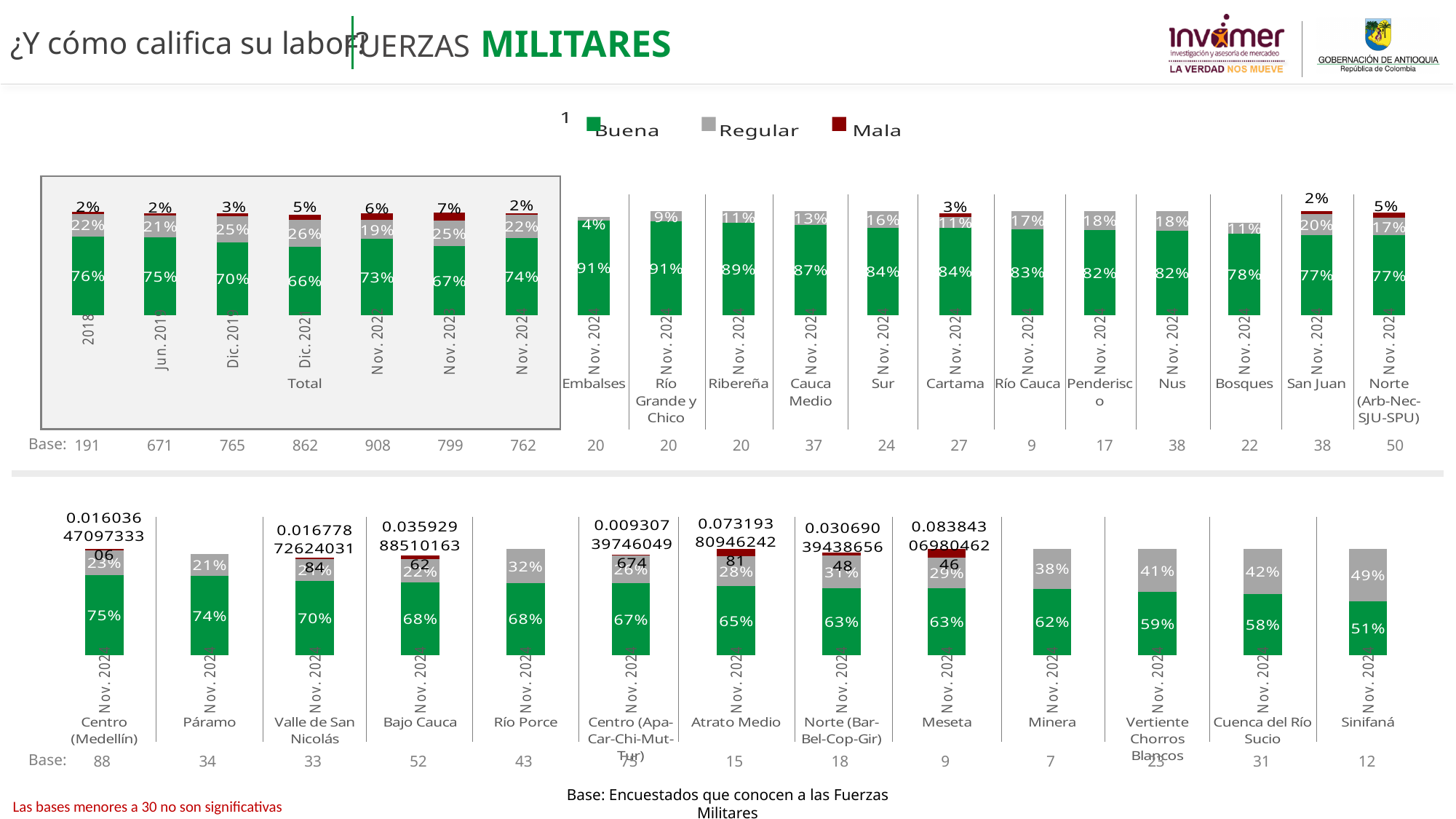
Which has a higher "Buena" percentage, Cauca Medio or Sur? Cauca Medio What is the "Buena" percentage for Sinifaná? 51% In the Total series, what is the difference in percentage points between the "Buena" value for 2018 and for Nov. 2024? 2 What percentage of respondents rated the Fuerzas Militares as "Buena" in the Embalses subregion? 91% Across the subregions in the bottom row from left to right, does the "Buena" percentage rise or fall? Fall What is the "Regular" percentage for Minera? 38% Among the subregions in the bottom row, which has the lowest "Buena" percentage? Sinifaná In the Total series, which period has the highest "Buena" percentage? 2018 What kind of chart is shown on the slide? Stacked bar chart How many series does the legend list? 3 What is the "Regular" percentage for Cuenca del Río Sucio? 42% In the Total series, what is the "Mala" percentage for Nov. 2023? 7%